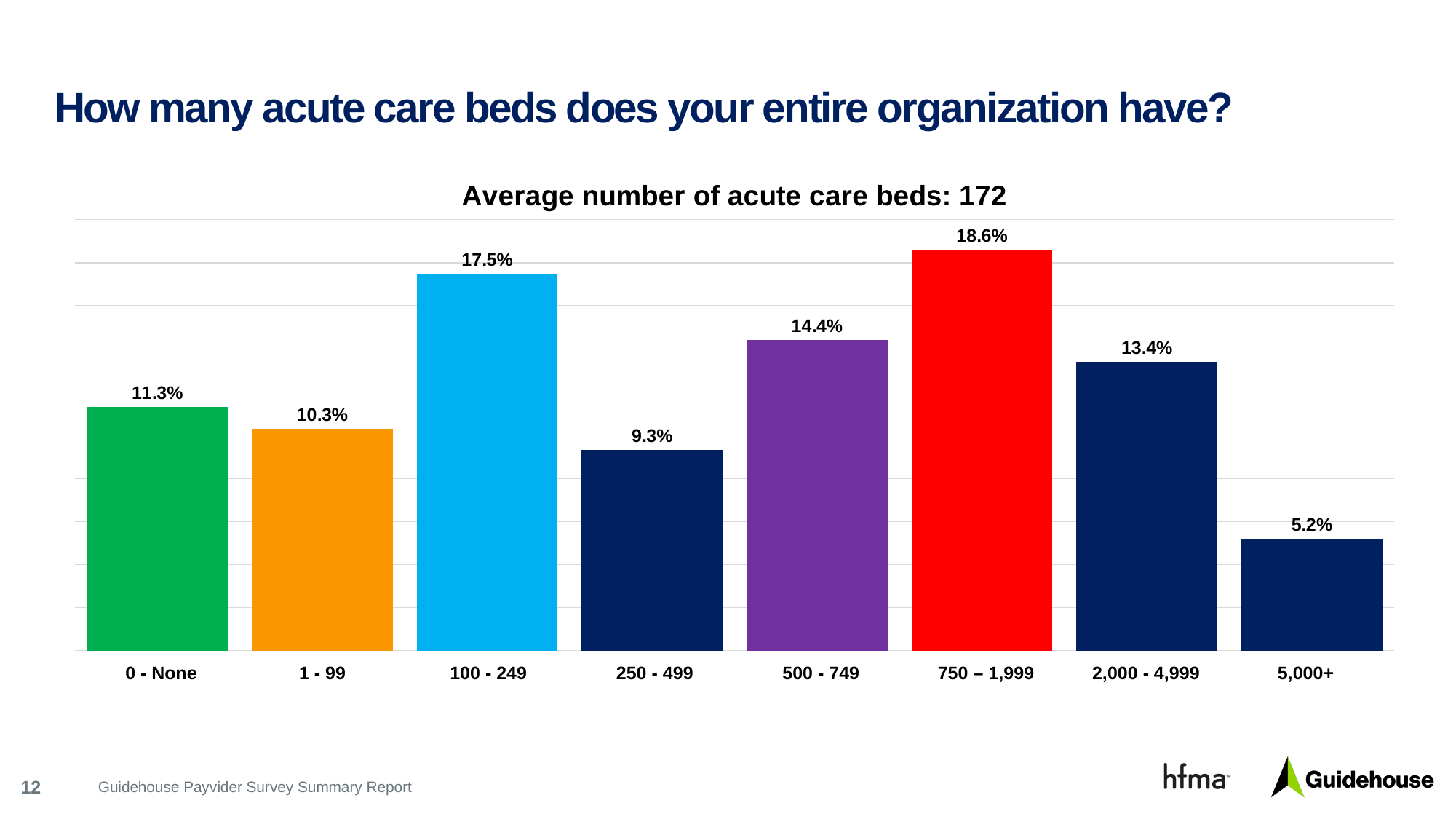
What is the difference between the 500 - 749 and 250 - 499 percentages? 5.1% What percentage of respondents reported 100 - 249 acute care beds? 17.5% Which is larger, the value for 1 - 99 or the value for 2,000 - 4,999? 2,000 - 4,999 What is the value for the 5,000+ category? 5.2% How many bed-count categories are shown on the chart? 8 Which bed-count category has the highest percentage? 750 – 1,999 What colour is the bar for the 750 – 1,999 category? Red Which bed-count category has the lowest percentage? 5,000+ What type of chart is shown on the slide? Bar chart What percentage is shown for the 0 - None category? 11.3% What is the chart's title? Average number of acute care beds: 172 What is the difference between the 750 – 1,999 and 100 - 249 percentages? 1.1%